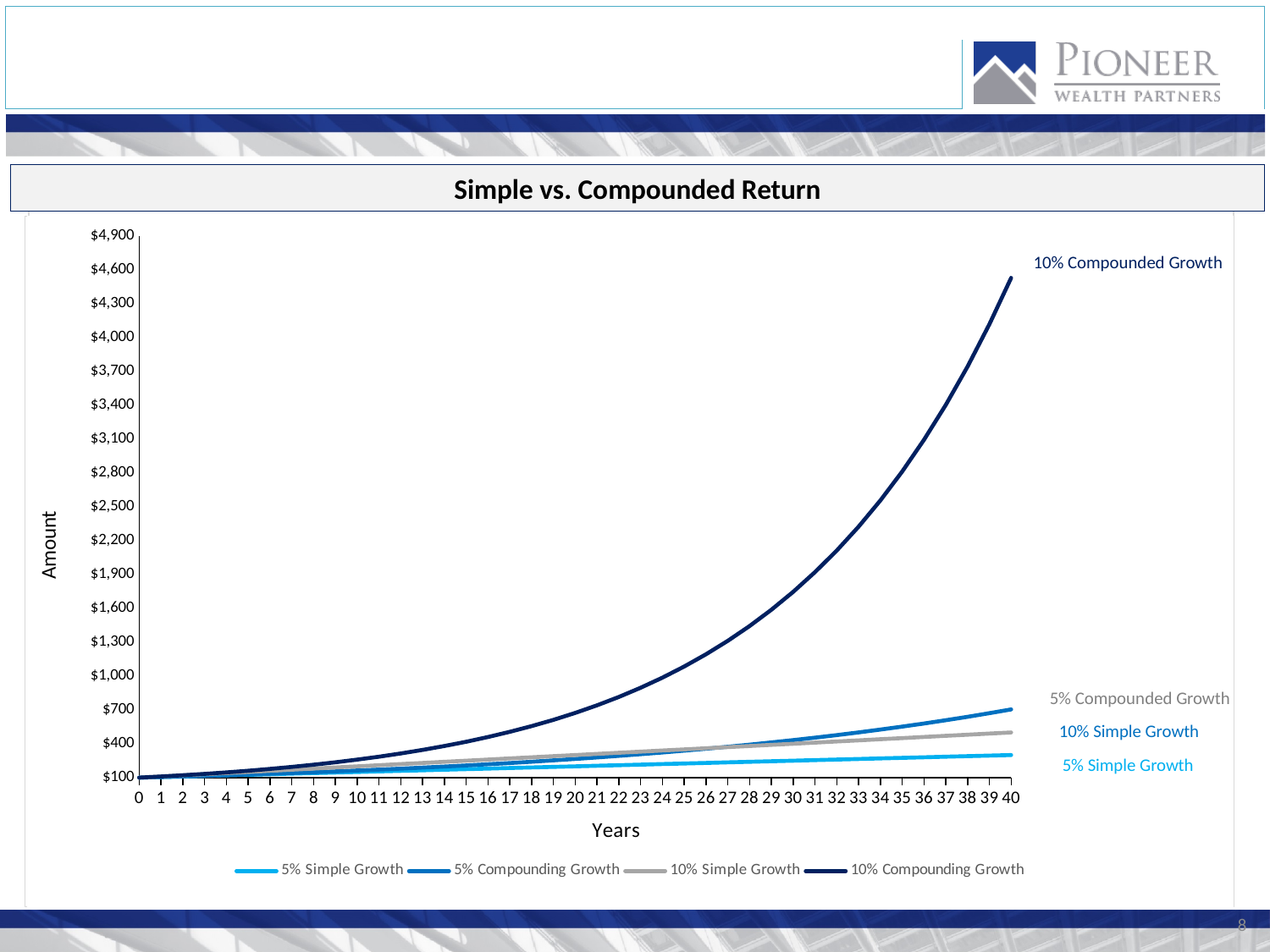
What kind of chart is shown on the slide? line chart Is the value of 10% Compounding Growth at year 20 greater or less than $1,000? less Do the values of 10% Compounding Growth rise or fall as the years increase? rise Is the value of 10% Compounding Growth at year 40 greater or less than $4,300? greater At year 40, which is larger: 5% Compounding Growth or 10% Simple Growth? 5% Compounding Growth Is the value of 5% Simple Growth at year 40 greater or less than $400? less What is the label of the vertical axis? Amount What is the value of all four series at year 0? $100 Which series has the lowest value at year 40? 5% Simple Growth How many series does the legend list? 4 What is the title of the chart? Simple vs. Compounded Return Which series has the highest value at year 40? 10% Compounding Growth